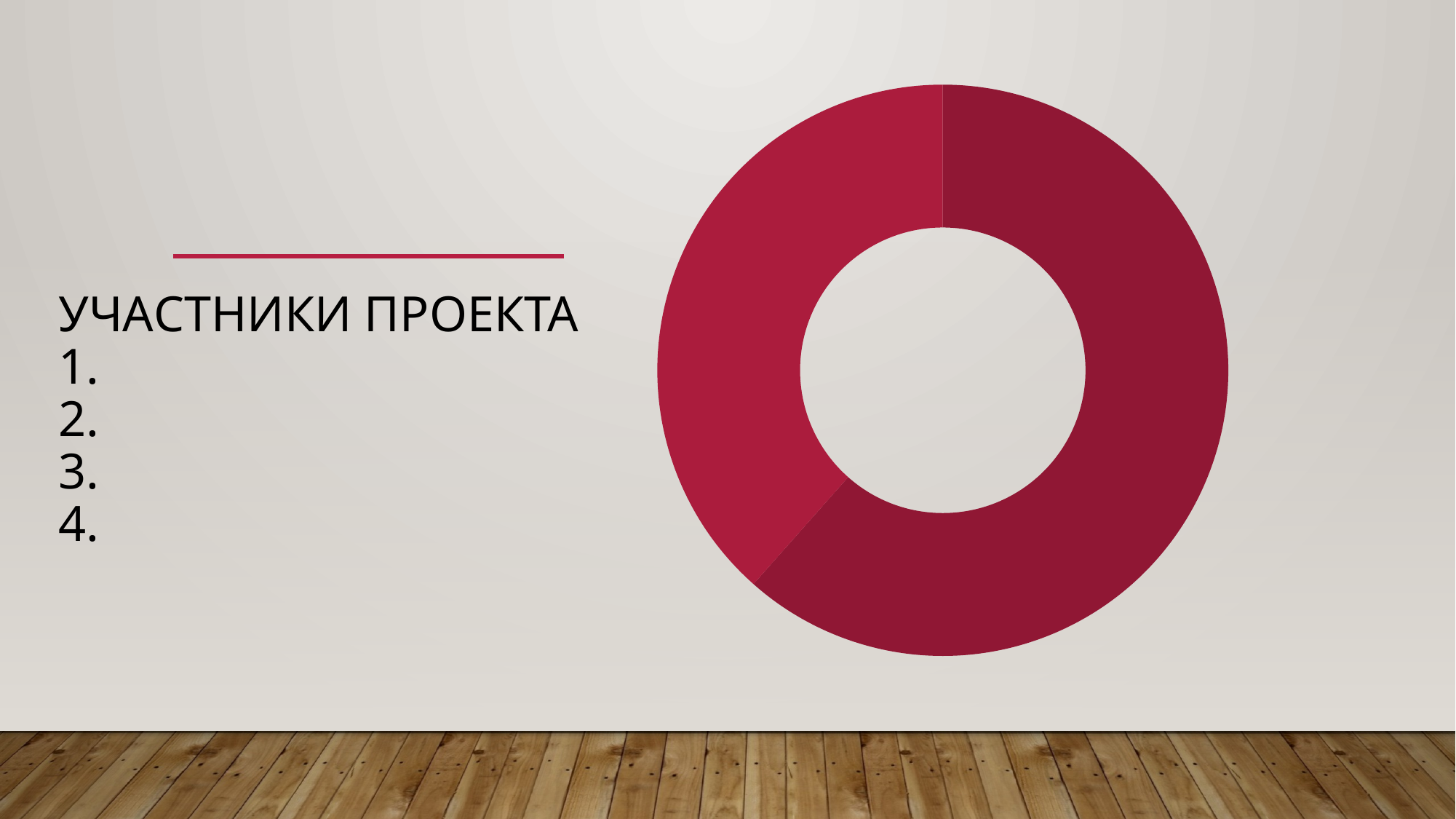
Does the doughnut chart on the slide show a legend? No What kind of chart is shown on the slide? doughnut chart Does the doughnut chart on the slide display any data labels? No How many slices does the doughnut chart on the slide have? 3 Which slice of the doughnut chart is the smallest: the right-hand slice, the left-hand slice, or the bottom slice? the bottom slice Which slice of the doughnut chart is the largest: the right-hand slice, the left-hand slice, or the bottom slice? the right-hand slice Is the right-hand slice of the doughnut chart larger or smaller than the bottom slice? larger